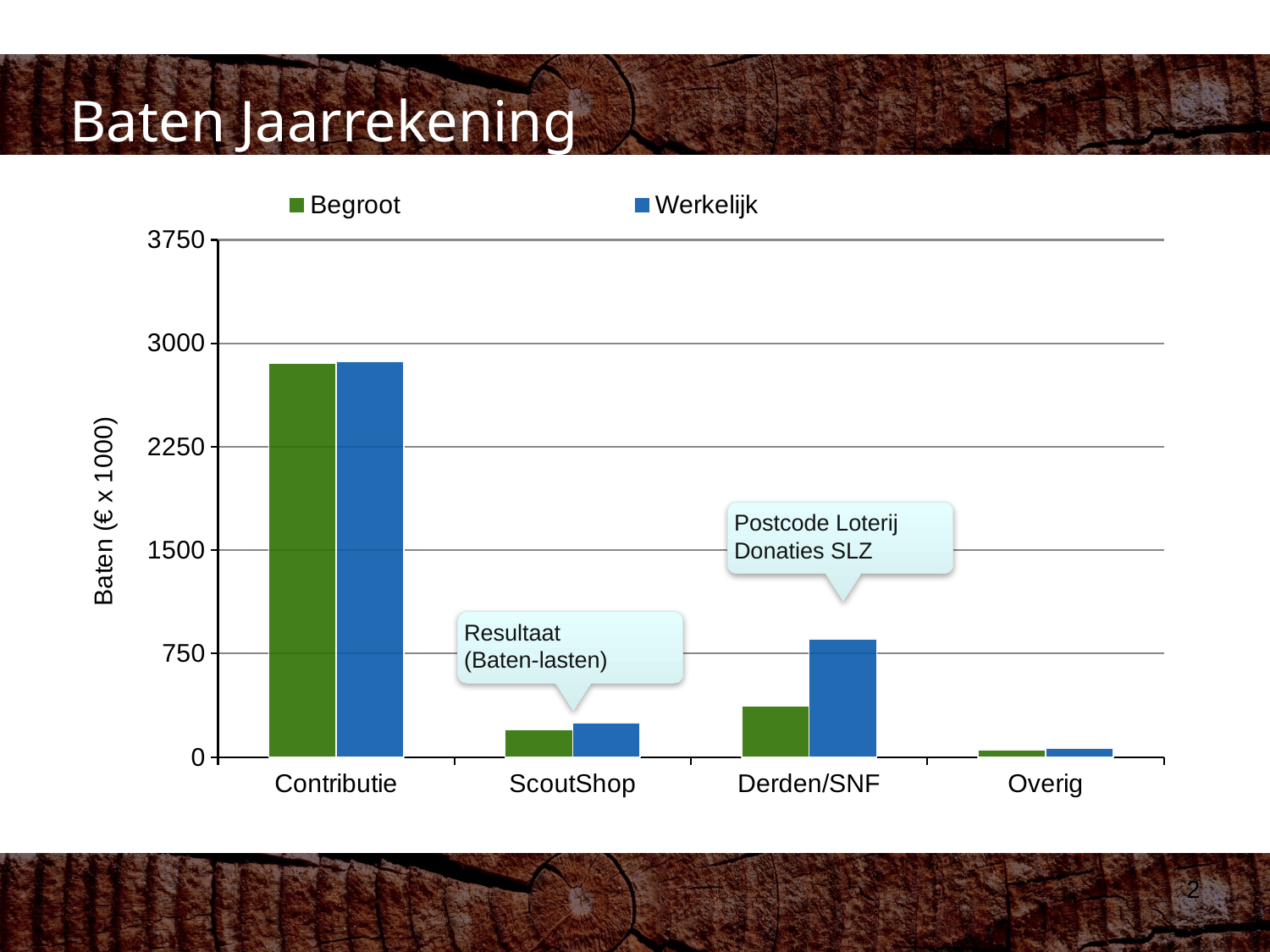
Which category has the lowest Begroot value? Overig For Derden/SNF, which is larger: Begroot or Werkelijk? Werkelijk What is the title of the vertical axis? Baten (€ x 1000) Is the Begroot value for Contributie greater or less than 2250? greater How many series does the legend list? 2 Is the Werkelijk value for ScoutShop greater or less than 750? less How many categories are shown on the x axis? 4 What colour represents the Werkelijk series? blue Is the Werkelijk value for Derden/SNF greater or less than 750? greater What kind of chart is shown on the slide? bar chart Which category has the highest Werkelijk value? Contributie